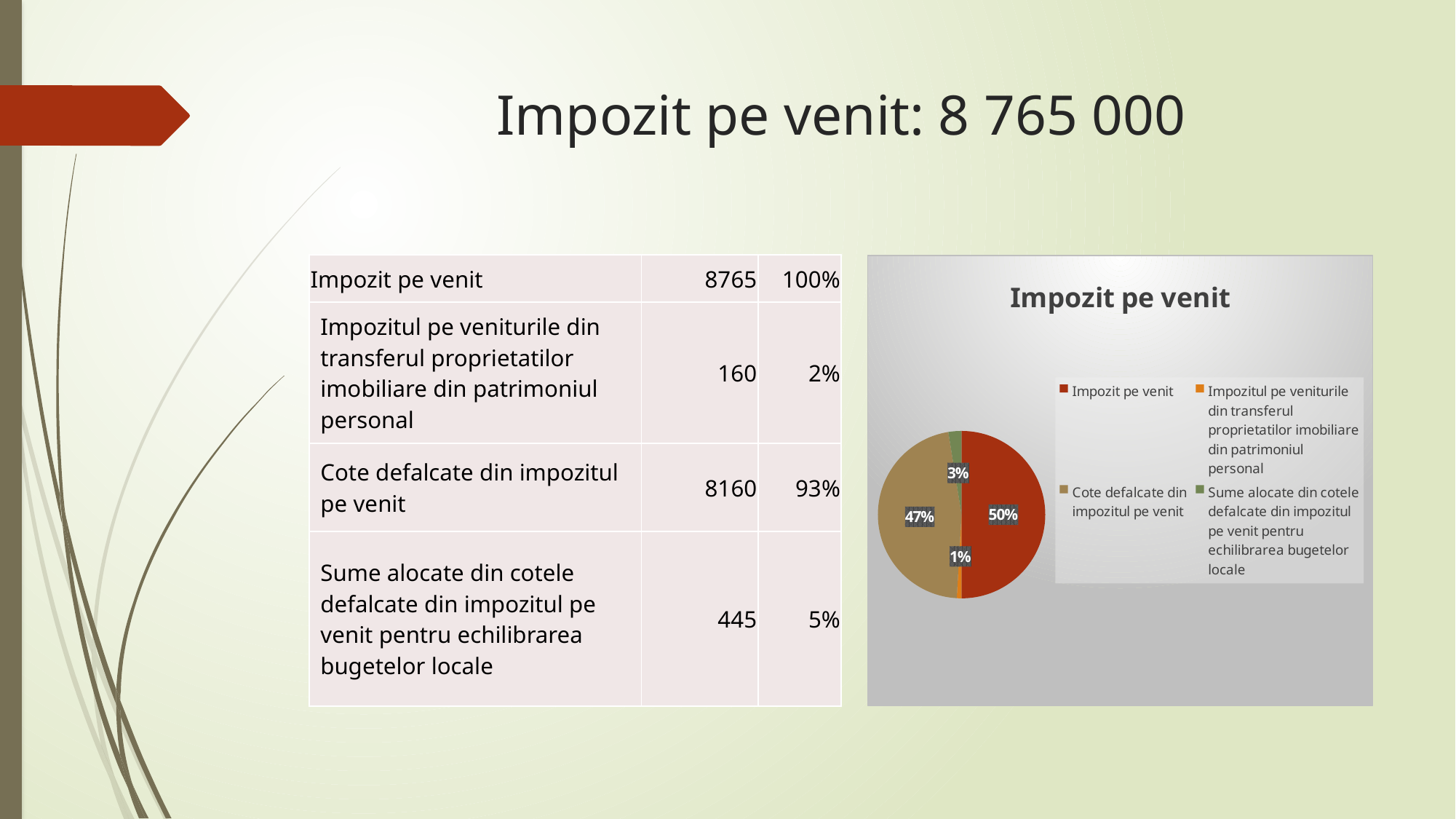
What share of the pie does the 'Cote defalcate din impozitul pe venit' slice represent? 47% What percentage is shown for the 'Impozitul pe veniturile din transferul proprietatilor imobiliare din patrimoniul personal' slice? 1% Which slice of the pie chart is the largest? Impozit pe venit What percentage is shown for the 'Sume alocate din cotele defalcate din impozitul pe venit pentru echilibrarea bugetelor locale' slice? 3% Which slice is larger: 'Sume alocate din cotele defalcate din impozitul pe venit pentru echilibrarea bugetelor locale' or 'Impozitul pe veniturile din transferul proprietatilor imobiliare din patrimoniul personal'? Sume alocate din cotele defalcate din impozitul pe venit pentru echilibrarea bugetelor locale Which slice of the pie chart is the smallest? Impozitul pe veniturile din transferul proprietatilor imobiliare din patrimoniul personal What kind of chart is shown on the slide? pie chart What is the title of the chart? Impozit pe venit How many slices does the pie chart have? 4 How many entries does the chart legend list? 4 What share of the pie does the 'Impozit pe venit' slice represent? 50% What is the difference in percentage points between the 'Impozit pe venit' slice and the 'Cote defalcate din impozitul pe venit' slice? 3%